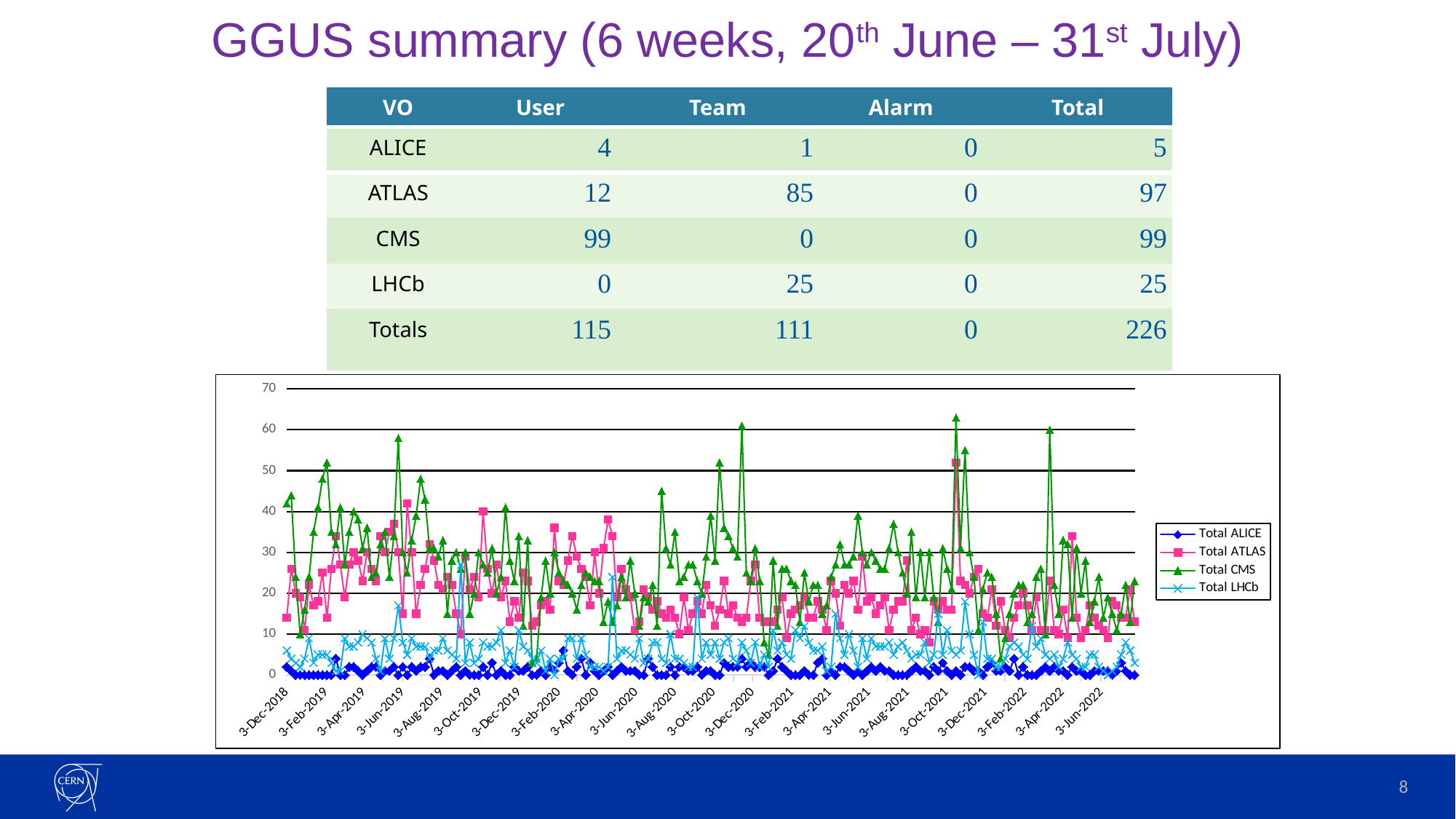
Which series in the line chart reaches the highest peak value? Total CMS Which series in the line chart stays at the lowest values throughout the period? Total ALICE Is the highest peak of the Total CMS series greater or less than 50? greater Around 3-Dec-2018, which series has the larger value, Total CMS or Total ALICE? Total CMS What is the highest value shown on the y axis of the line chart? 70 How many series does the legend of the line chart list? 4 What kind of chart is shown at the bottom of the slide? line chart Is the value for Total ATLAS at 3-Dec-2018 greater or less than 10? greater Is the value for Total ALICE at 3-Dec-2018 greater or less than 10? less What are the series names listed in the legend of the line chart? Total ALICE, Total ATLAS, Total CMS, Total LHCb